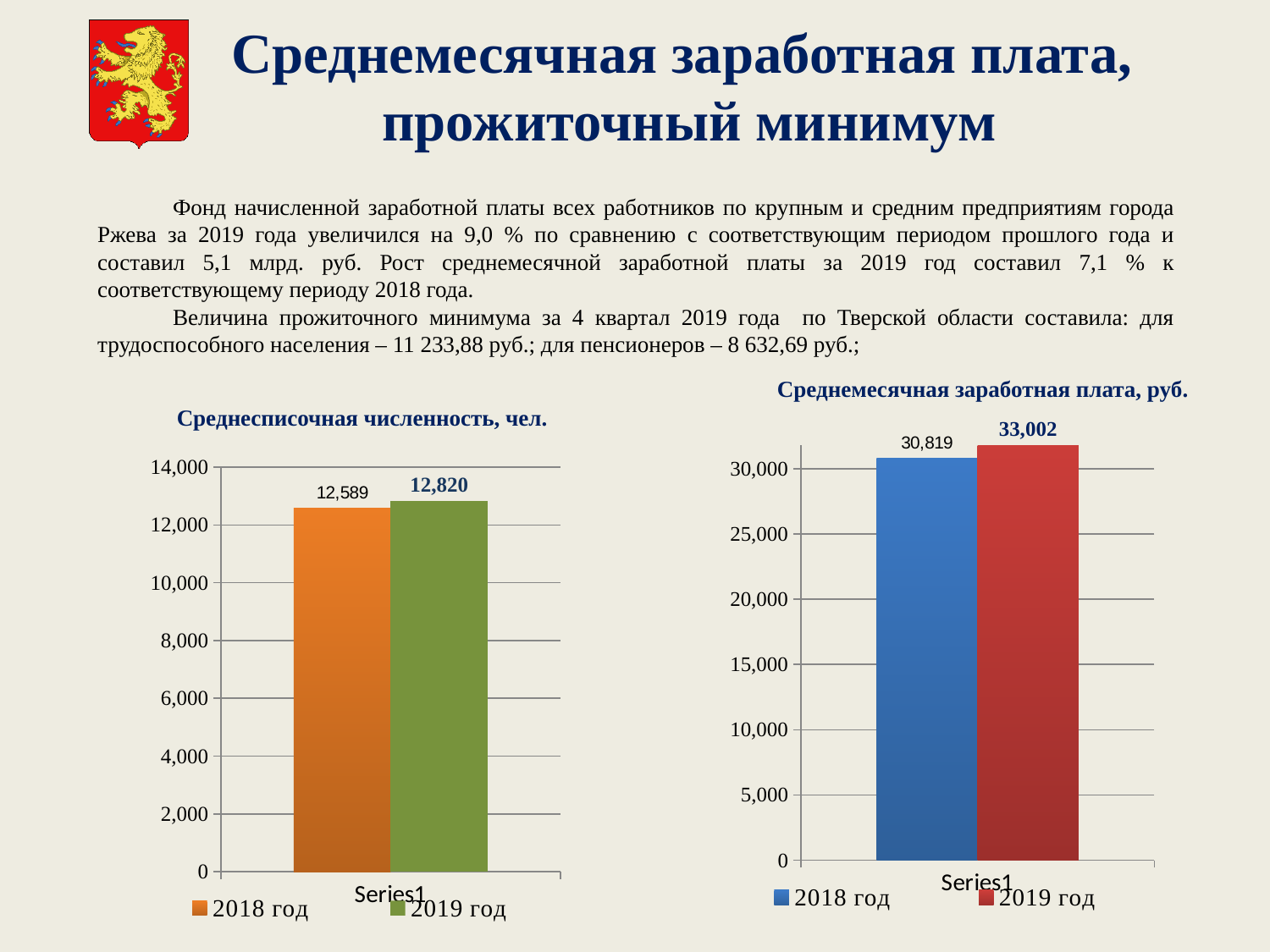
In the chart titled "Среднесписочная численность, чел.", which year has the lower value? 2018 год In the chart titled "Среднесписочная численность, чел.", what is the difference between the 2019 год and 2018 год values? 231 In the chart titled "Среднесписочная численность, чел.", what is the value for 2019 год? 12,820 In the chart titled "Среднемесячная заработная плата, руб.", which year has the higher value? 2019 год How many series does the legend list in the chart titled "Среднесписочная численность, чел."? 2 What kind of chart is the one titled "Среднемесячная заработная плата, руб."? bar chart In the chart titled "Среднемесячная заработная плата, руб.", what is the value for 2019 год? 33,002 In the chart titled "Среднесписочная численность, чел.", what is the value for 2018 год? 12,589 In the chart titled "Среднемесячная заработная плата, руб.", what colour is the bar for 2019 год? red In the chart titled "Среднемесячная заработная плата, руб.", is the value for 2018 год greater or less than 30,000? greater In the chart titled "Среднемесячная заработная плата, руб.", what is the value for 2018 год? 30,819 In the chart titled "Среднемесячная заработная плата, руб.", what is the difference between the 2019 год and 2018 год values? 2,183